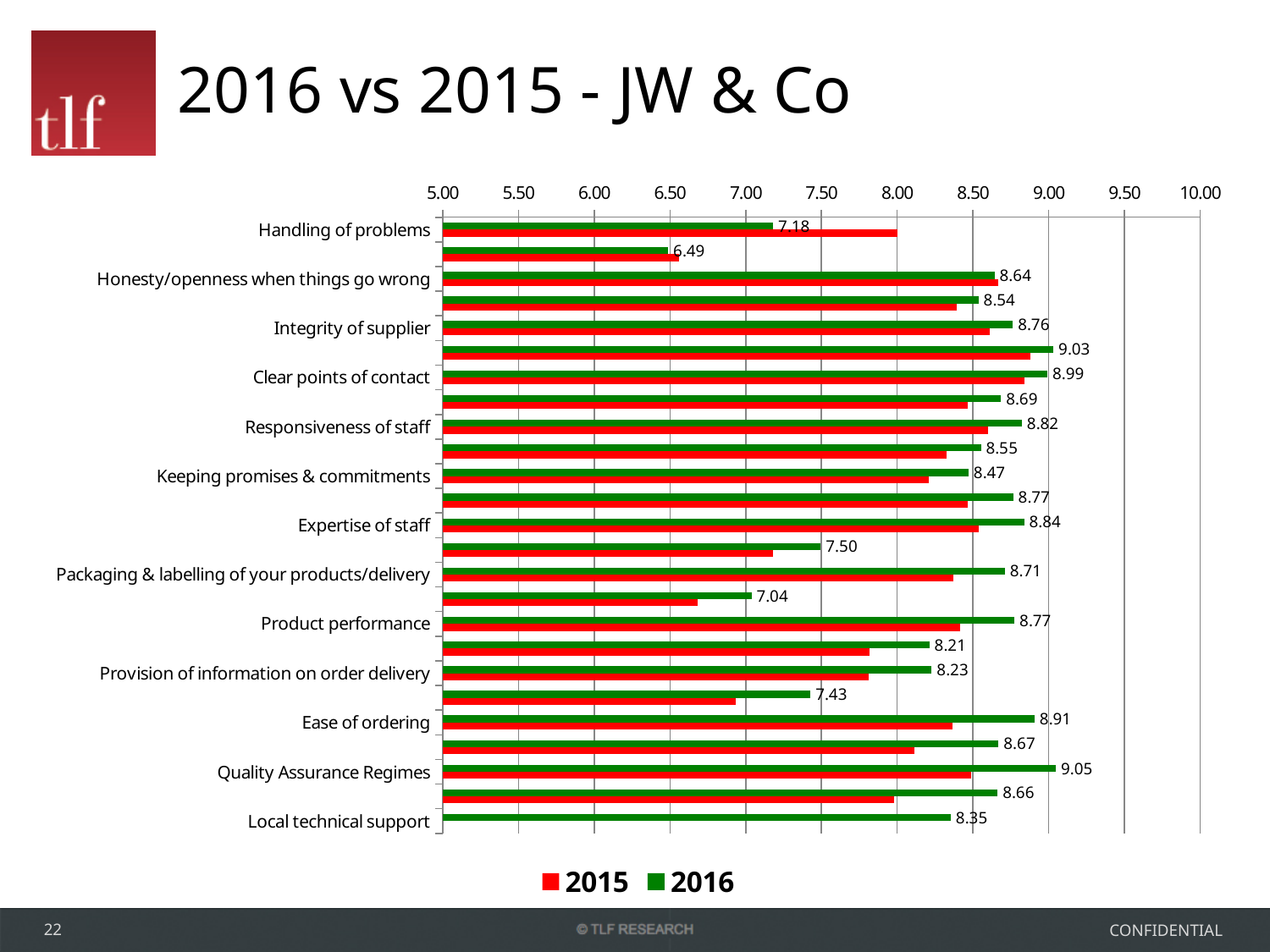
What is the 2016 value for Local technical support? 8.35 Is the 2015 value for Ease of ordering greater or less than 8.50? less What is the 2016 value for Clear points of contact? 8.99 What is the 2016 value for Handling of problems? 7.18 What is the 2016 value for Quality Assurance Regimes? 9.05 What kind of chart is shown on the slide? Bar chart How many series does the legend list? 2 What is the difference between the 2016 values for Quality Assurance Regimes and Local technical support? 0.70 What is the 2016 value for Provision of information on order delivery? 8.23 Which has the higher 2016 value, Clear points of contact or Responsiveness of staff? Clear points of contact For Handling of problems, which year has the higher value, 2015 or 2016? 2015 Is the 2015 value for Provision of information on order delivery greater or less than 8.00? less